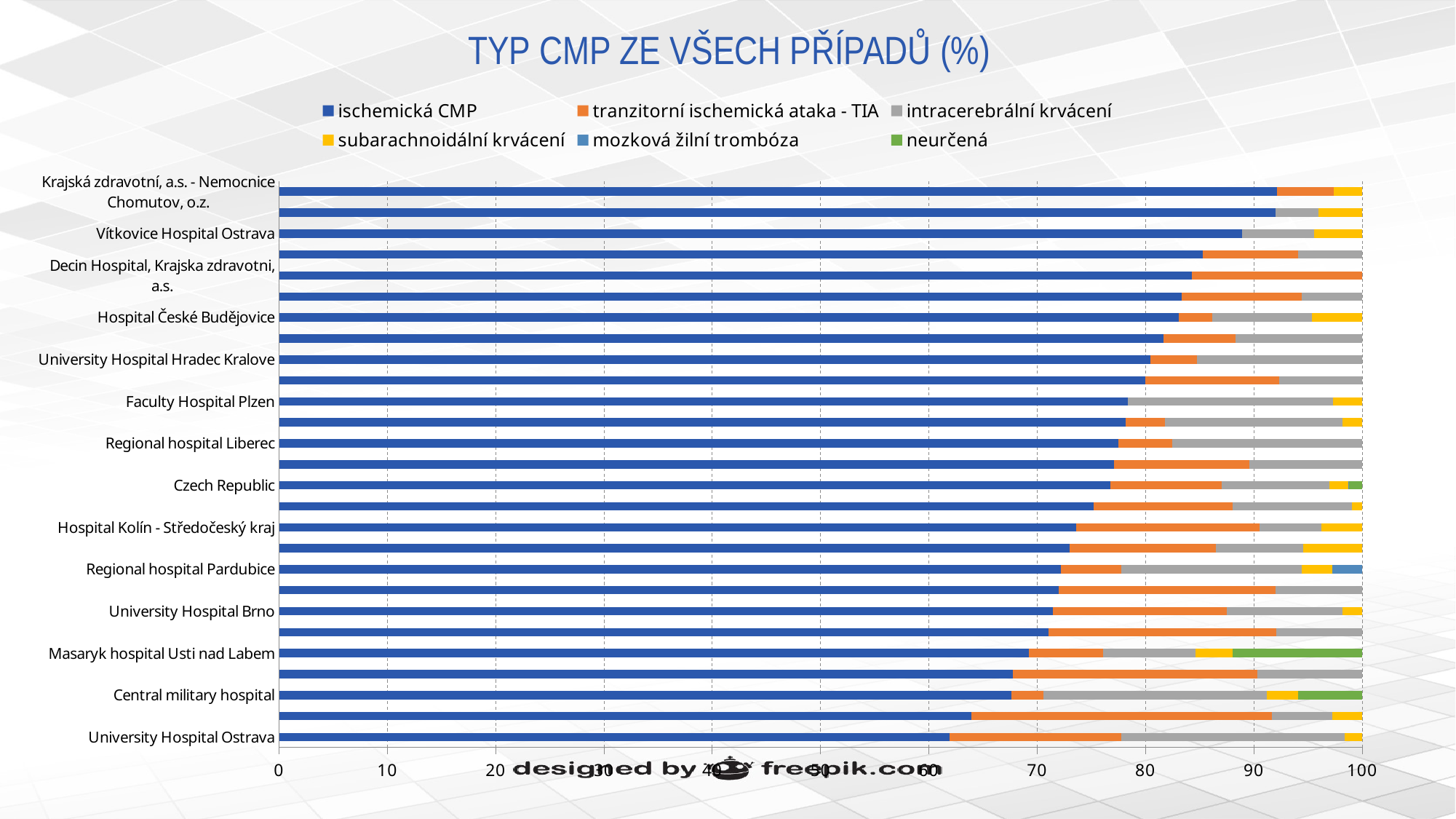
Is the ischemická CMP value for Krajská zdravotní, a.s. - Nemocnice Chomutov, o.z. greater or less than 90? greater What kind of chart is shown on the slide? stacked bar chart Which series is shown in green in the legend? neurčená Which has a larger ischemická CMP share, Vítkovice Hospital Ostrava or Faculty Hospital Plzen? Vítkovice Hospital Ostrava Is the ischemická CMP value for Central military hospital greater or less than 70? less Which labelled hospital has the highest share of ischemická CMP? Krajská zdravotní, a.s. - Nemocnice Chomutov, o.z. What is the title of the chart? TYP CMP ZE VŠECH PŘÍPADŮ (%) Is the ischemická CMP value for University Hospital Ostrava greater or less than 70? less Which labelled hospital has the largest neurčená segment? Masaryk hospital Usti nad Labem How many series does the legend list? 6 Which labelled hospital has the lowest share of ischemická CMP? University Hospital Ostrava